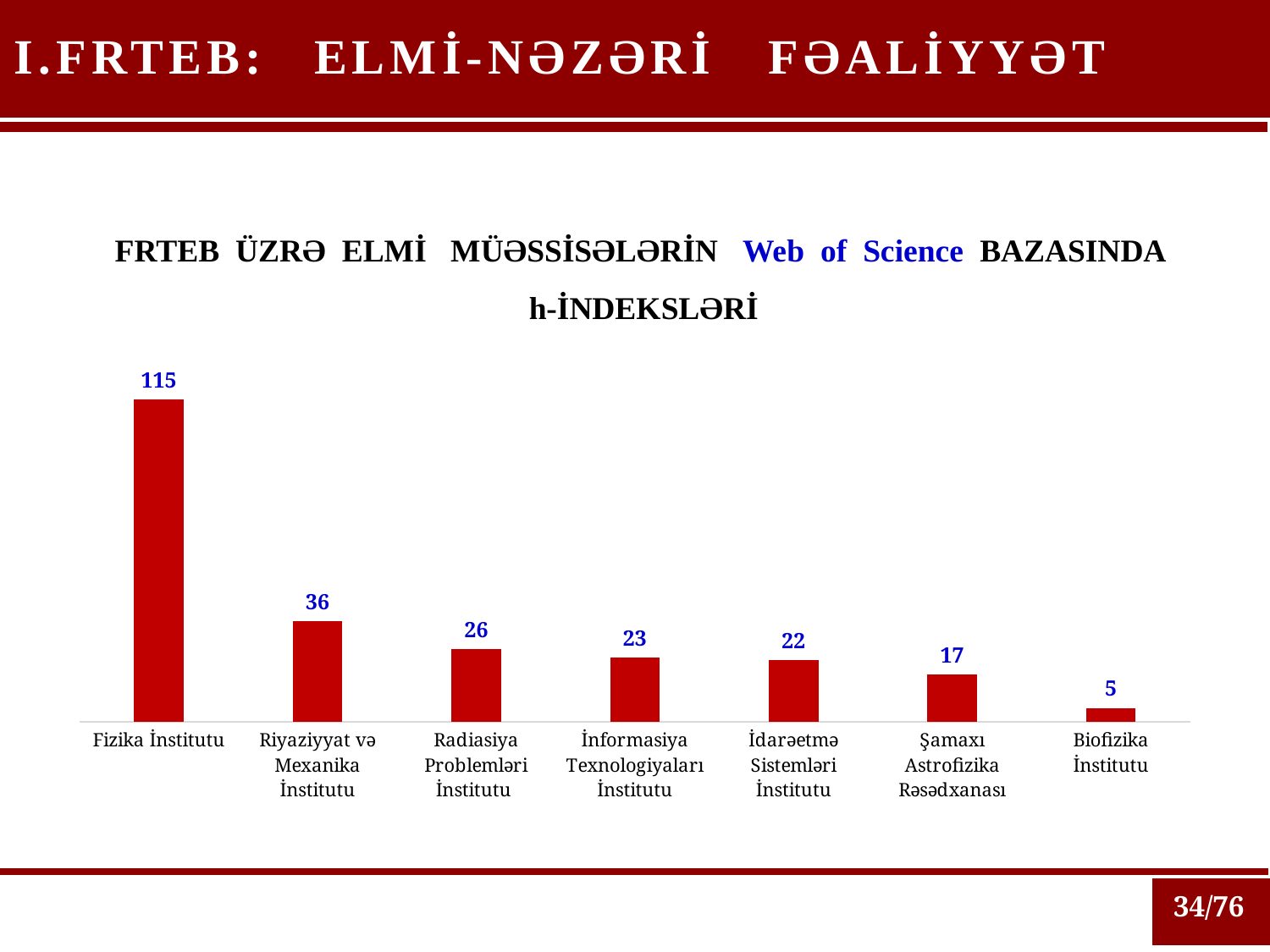
Which institution has the highest h-index on the chart? Fizika İnstitutu What is the h-index value shown for Fizika İnstitutu? 115 What value is shown for Biofizika İnstitutu? 5 What is the difference between the values for Radiasiya Problemləri İnstitutu and İdarəetmə Sistemləri İnstitutu? 4 Do the values rise or fall from left to right across the chart? Fall What value is shown for Riyaziyyat və Mexanika İnstitutu? 36 Which has a larger value: İnformasiya Texnologiyaları İnstitutu or Şamaxı Astrofizika Rəsədxanası? İnformasiya Texnologiyaları İnstitutu Which institution has the lowest h-index on the chart? Biofizika İnstitutu What value is shown for Şamaxı Astrofizika Rəsədxanası? 17 What kind of chart is shown on the slide? Bar chart What is the difference between the values for Fizika İnstitutu and Riyaziyyat və Mexanika İnstitutu? 79 How many institutions are shown on the chart? 7